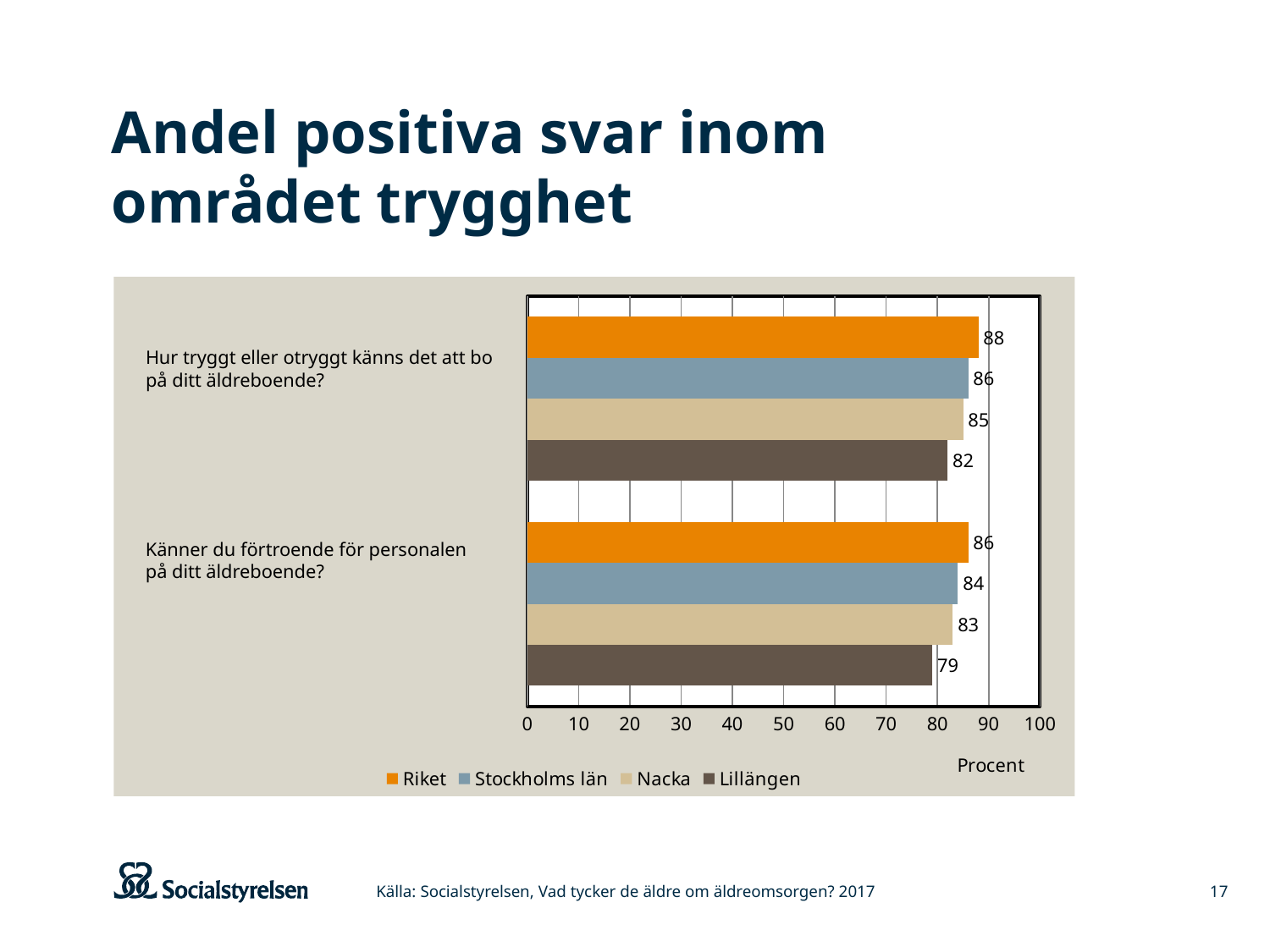
What is the value for Stockholms län for the question "Känner du förtroende för personalen på ditt äldreboende?"? 84 What is the label on the x axis of the chart? Procent Which series has the highest value for the question "Hur tryggt eller otryggt känns det att bo på ditt äldreboende?"? Riket What is the difference between the Nacka and Lillängen values for the question "Känner du förtroende för personalen på ditt äldreboende?"? 4 What is the value for Nacka for the question "Hur tryggt eller otryggt känns det att bo på ditt äldreboende?"? 85 What is the difference between the Riket and Lillängen values for the question "Hur tryggt eller otryggt känns det att bo på ditt äldreboende?"? 6 Which series has the lowest value for the question "Känner du förtroende för personalen på ditt äldreboende?"? Lillängen How many series does the legend list? 4 What kind of chart is shown on the slide? Bar chart What is the value for Riket for the question "Hur tryggt eller otryggt känns det att bo på ditt äldreboende?"? 88 What is the value for Lillängen for the question "Känner du förtroende för personalen på ditt äldreboende?"? 79 Is the Riket value higher for "Hur tryggt eller otryggt känns det att bo på ditt äldreboende?" or for "Känner du förtroende för personalen på ditt äldreboende?"? Hur tryggt eller otryggt känns det att bo på ditt äldreboende?